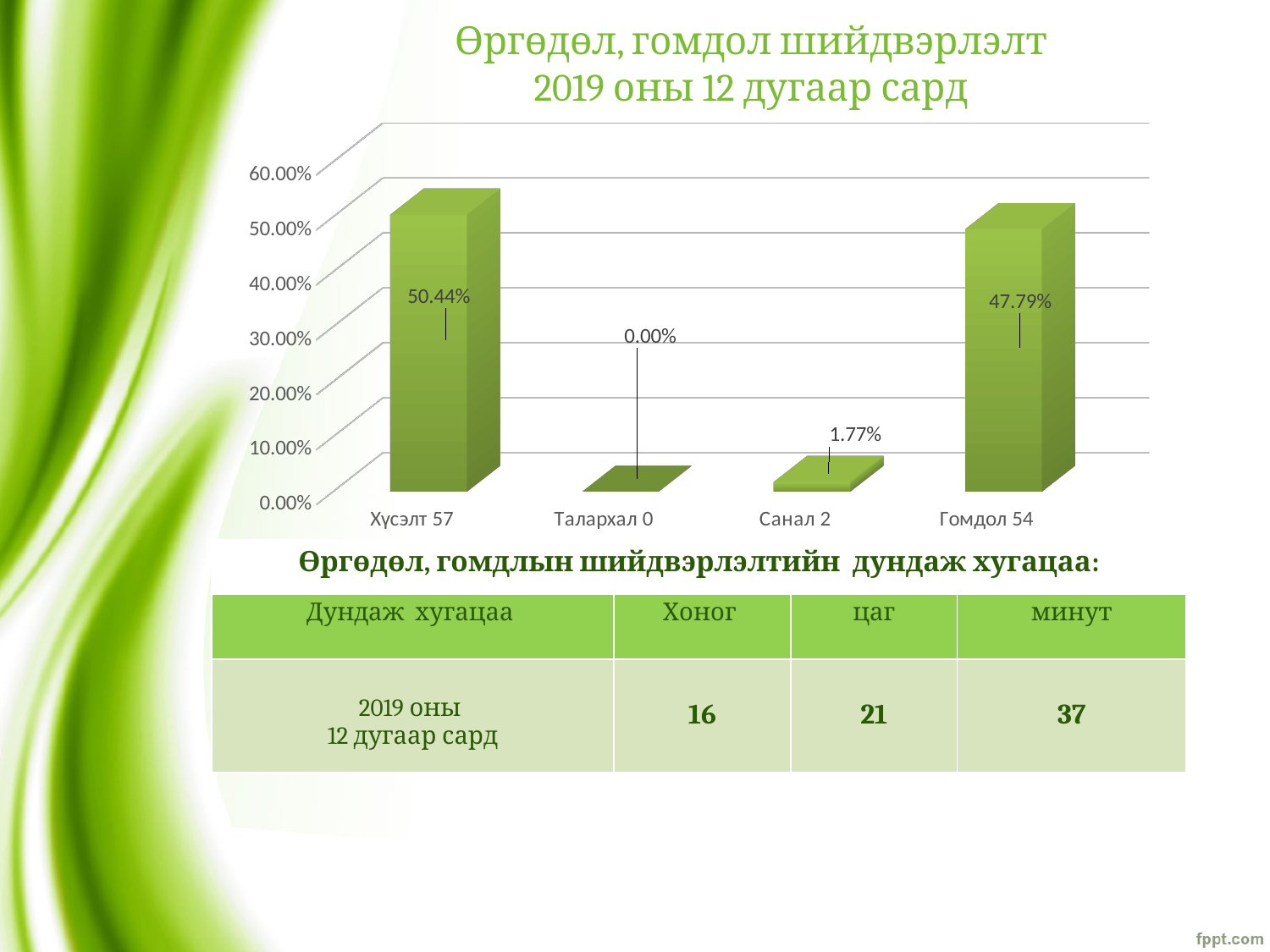
What is the difference between the values for Хүсэлт 57 and Гомдол 54? 2.65% Which category has the highest value? Хүсэлт 57 Is the value for Гомдол 54 greater or less than 40.00%? greater Which category has the lowest value? Талархал 0 What is the value for Талархал 0? 0.00% How many categories are shown on the x axis of the chart? 4 What is the value for Гомдол 54? 47.79% What kind of chart is shown on the slide? bar chart What is the title of the chart? Өргөдөл, гомдол шийдвэрлэлт 2019 оны 12 дугаар сард Which is larger, the value for Санал 2 or the value for Гомдол 54? Гомдол 54 What is the value for Хүсэлт 57? 50.44% What is the value for Санал 2? 1.77%